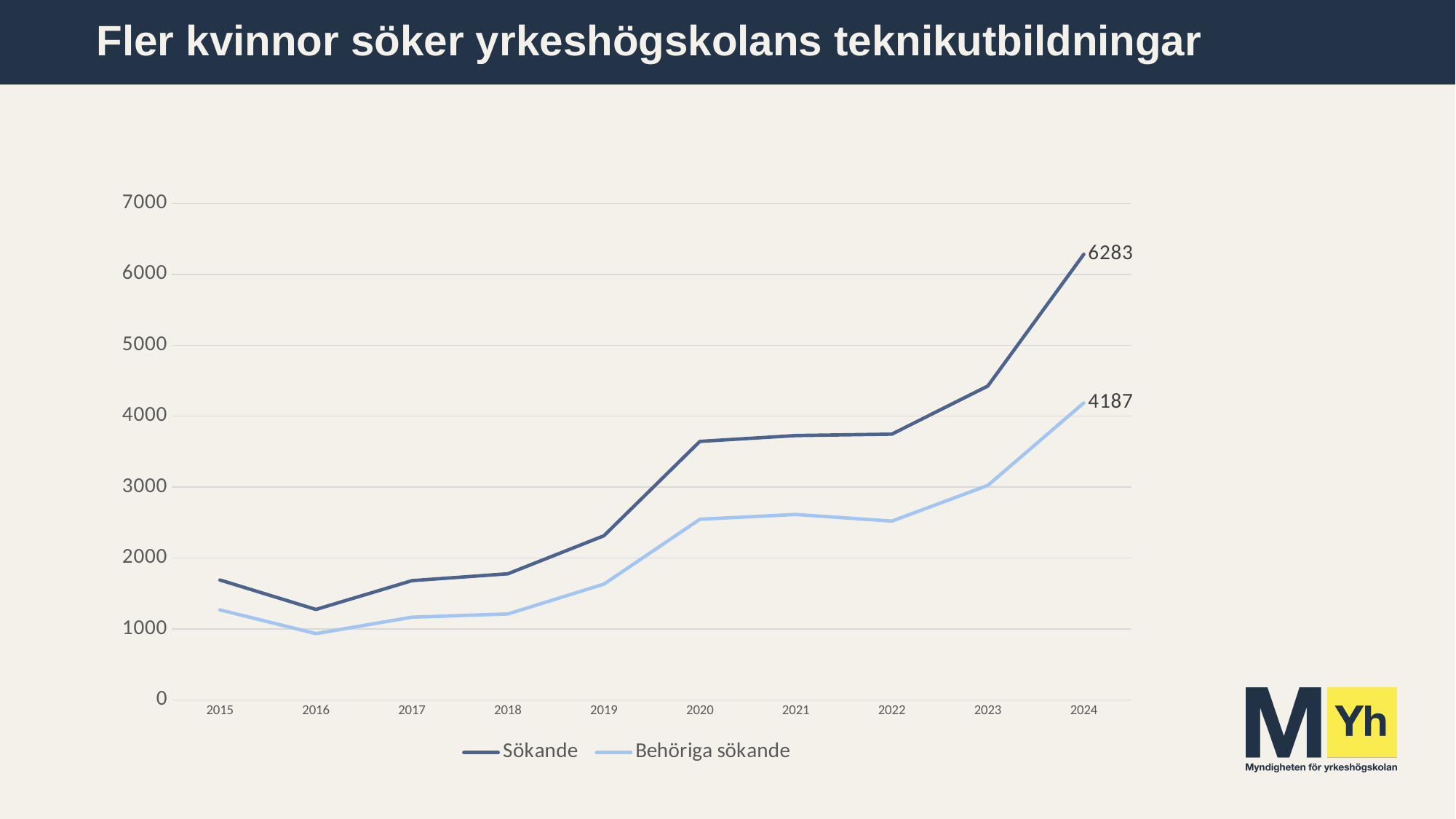
In which year is the Behöriga sökande series at its lowest? 2016 Is the value for Behöriga sökande in 2019 greater or less than 2000? less What is the value for Behöriga sökande in 2024? 4187 How many series does the legend list? 2 What is the value for Sökande in 2024? 6283 What kind of chart is shown on the slide? line chart Is the value for Sökande in 2020 greater or less than 3000? greater How many years are shown on the x axis? 10 In 2024, which series has the larger value, Sökande or Behöriga sökande? Sökande What is the difference between Sökande and Behöriga sökande in 2024? 2096 In which year is the Sökande series at its highest? 2024 In which year is the Sökande series at its lowest? 2016